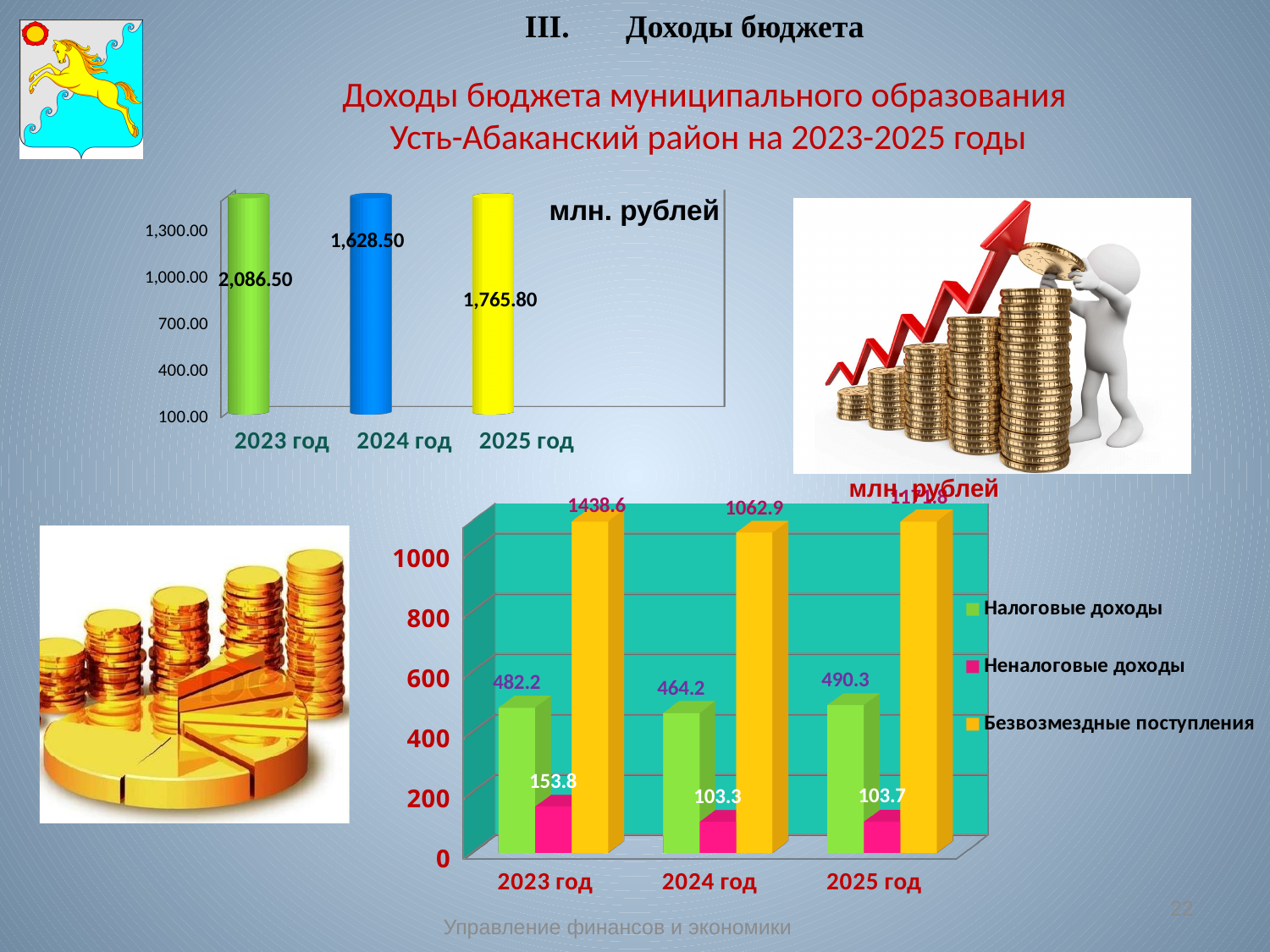
In the bottom chart, what is the value of Налоговые доходы for 2025 год? 490.3 In the bottom chart, is Налоговые доходы larger in 2023 год or 2024 год? 2023 год In the bottom chart, what is the difference between Безвозмездные поступления in 2023 год and 2024 год? 375.7 In the bottom chart, what is the value of Неналоговые доходы for 2023 год? 153.8 In the top chart, what is the difference between the 2023 год and 2024 год values? 458.00 In the top chart, which year has the lowest value? 2024 год How many series does the legend of the bottom chart list? 3 In the top chart, what is the value for 2023 год? 2,086.50 In the top chart, how many years are shown? 3 In the bottom chart, in which year is Неналоговые доходы highest? 2023 год In the top chart, what is the value for 2024 год? 1,628.50 What kind of chart is the top chart? Bar chart